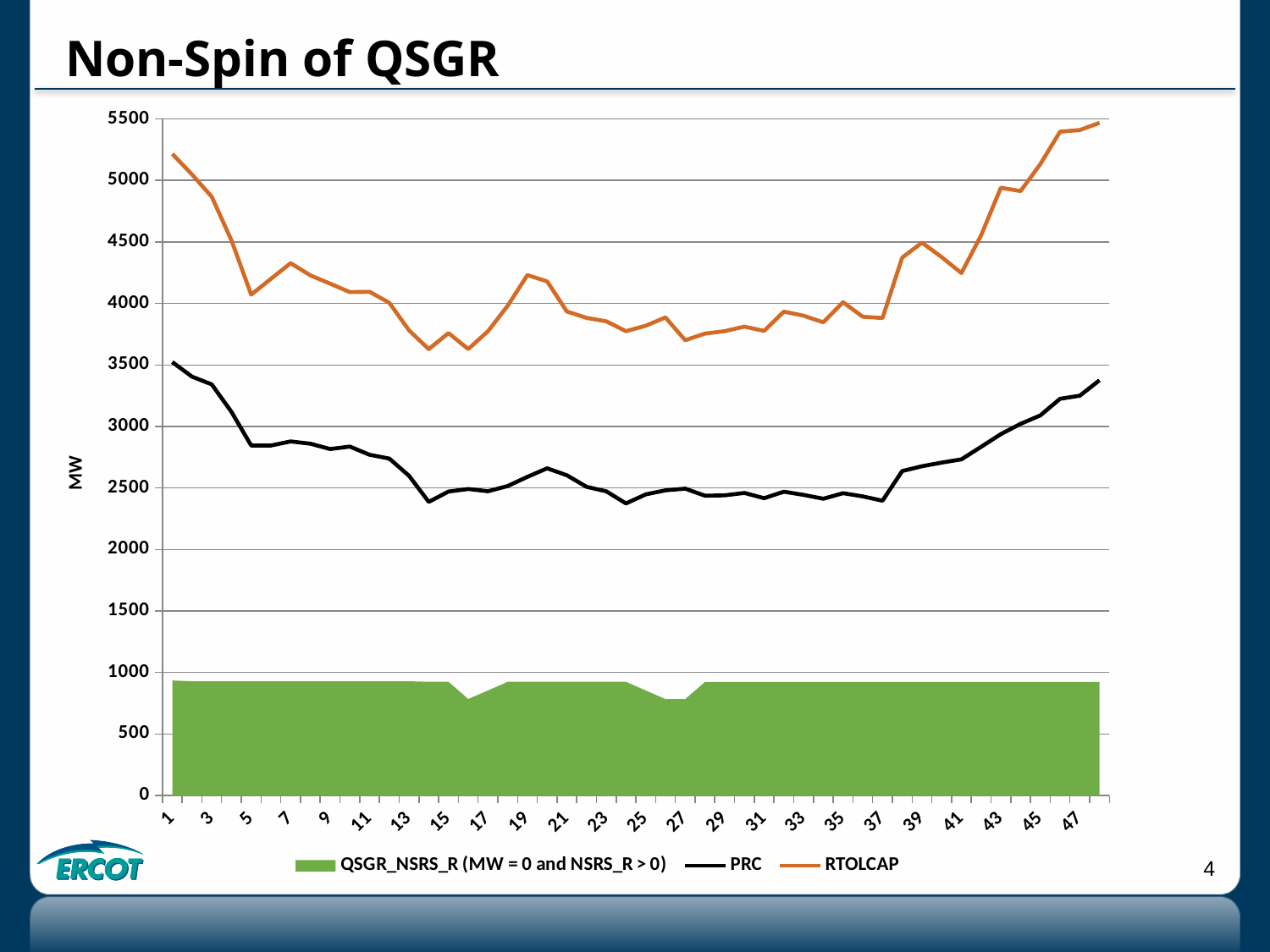
What is the title of the chart? Non-Spin of QSGR Is the value of RTOLCAP at x = 1 greater or less than 5000? greater How many series does the legend list? 3 Is the value of RTOLCAP at x = 47 greater or less than 5000? greater What kind of chart is used to plot the PRC and RTOLCAP series? line chart Which series is larger at x = 21, PRC or RTOLCAP? RTOLCAP Is the value of the green QSGR_NSRS_R area at x = 1 greater or less than 1000? less What is the label on the y axis? MW Does the RTOLCAP series rise or fall from x = 1 to x = 5? fall Does the PRC series rise or fall from x = 37 to x = 47? rise